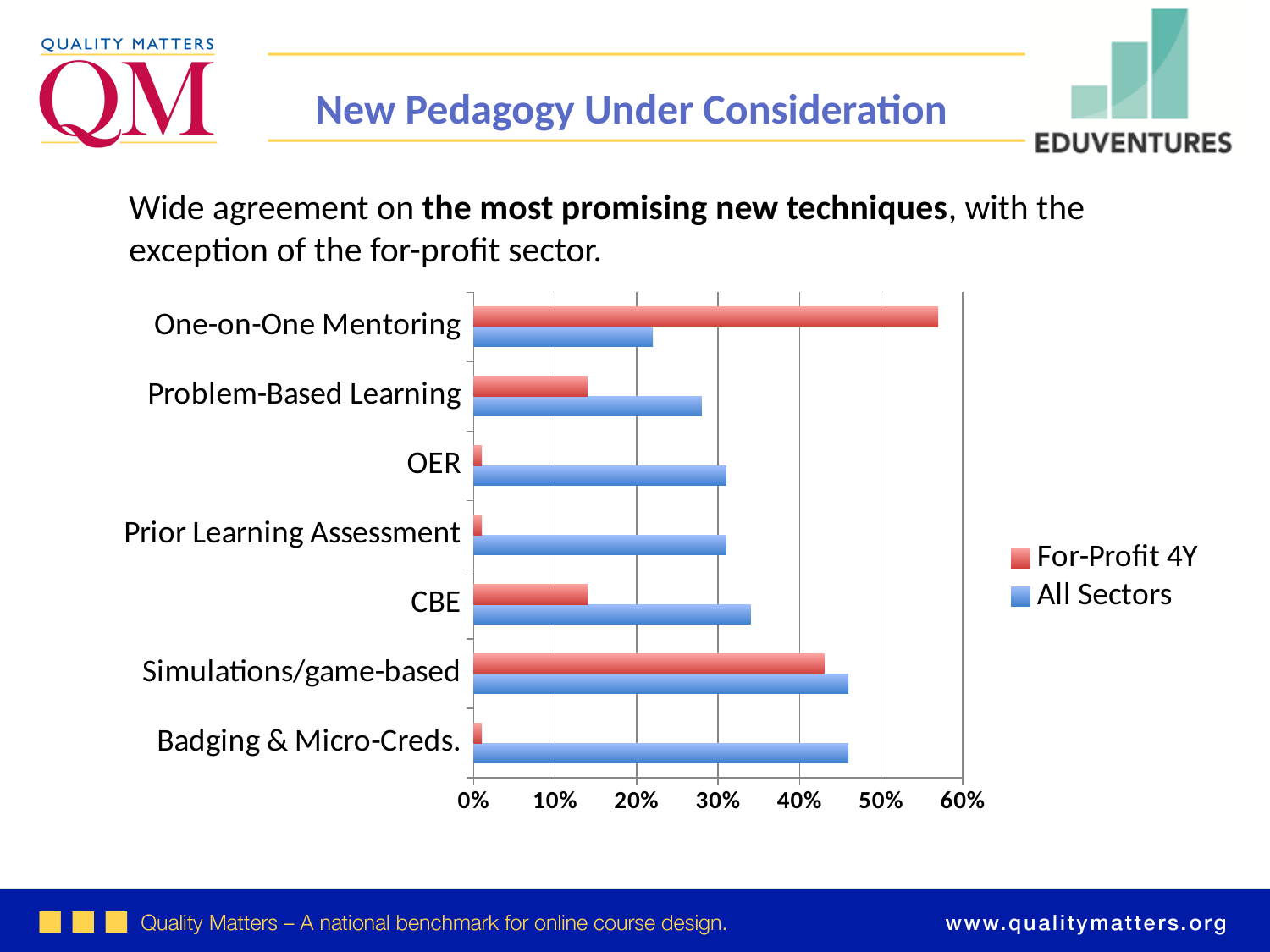
What kind of chart is shown on the slide? bar chart Is the For-Profit 4Y value for Simulations/game-based greater or less than 40%? greater For One-on-One Mentoring, which series has the larger value, For-Profit 4Y or All Sectors? For-Profit 4Y Which category has the highest For-Profit 4Y value? One-on-One Mentoring Which category has the lowest All Sectors value? One-on-One Mentoring For Problem-Based Learning, which series has the larger value, For-Profit 4Y or All Sectors? All Sectors Which colour represents the All Sectors series in the legend? blue How many series does the legend list? 2 Is the For-Profit 4Y value for Badging & Micro-Creds. greater or less than 10%? less Is the For-Profit 4Y value for One-on-One Mentoring greater or less than 50%? greater How many pedagogy categories are plotted on the chart? 7